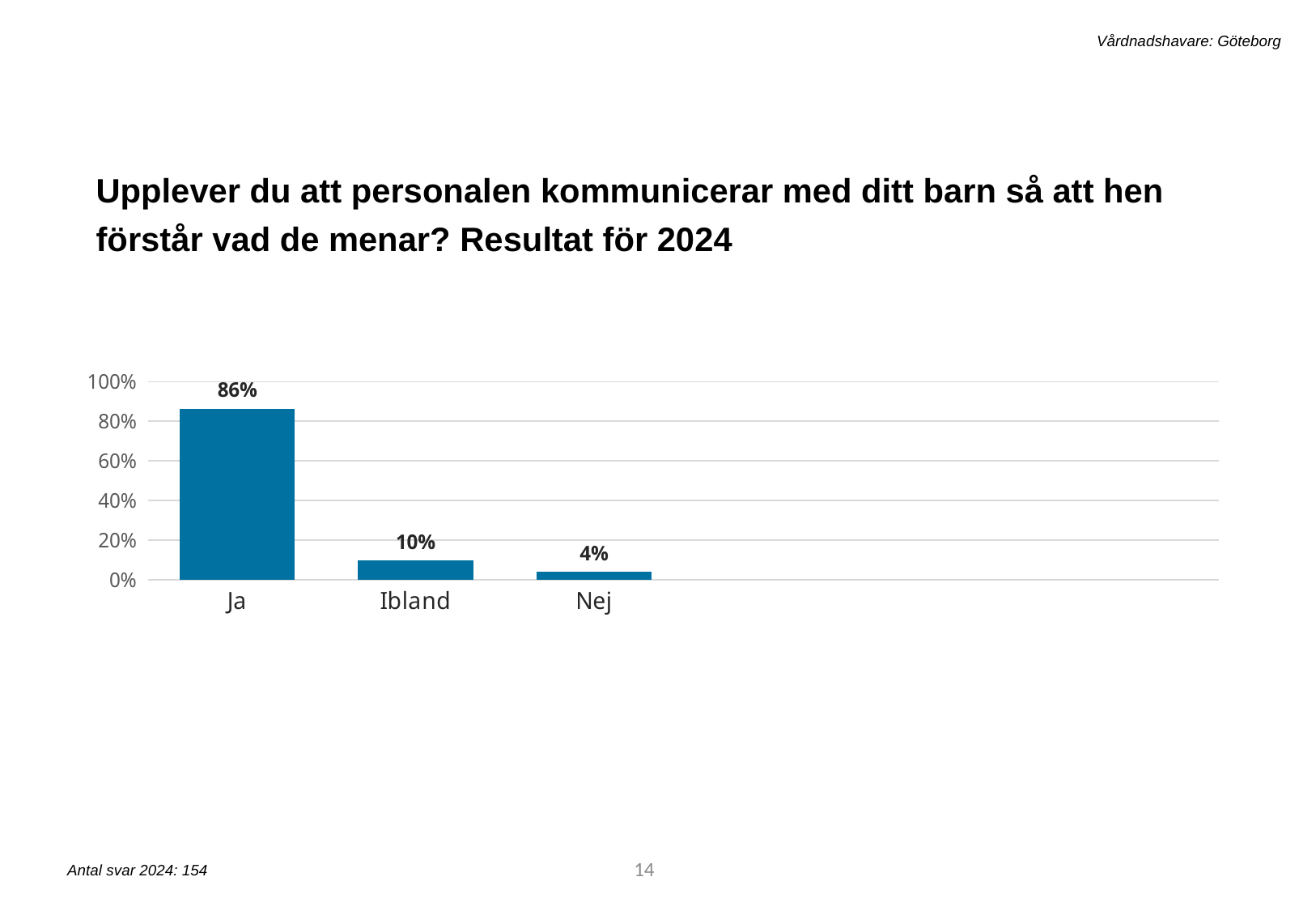
What is the value for Nej? 4% Which category has the highest value? Ja What is the difference between the values for Ibland and Nej? 6% Is the value for Ja greater or less than 80%? greater What is the value for Ibland? 10% What kind of chart is shown on the slide? bar chart What is the value for Ja? 86% Which is larger, the value for Ibland or the value for Nej? Ibland How many categories are shown on the x axis? 3 Which category has the lowest value? Nej What is the difference between the values for Ja and Ibland? 76% Do the values rise or fall from left to right along the x axis? fall